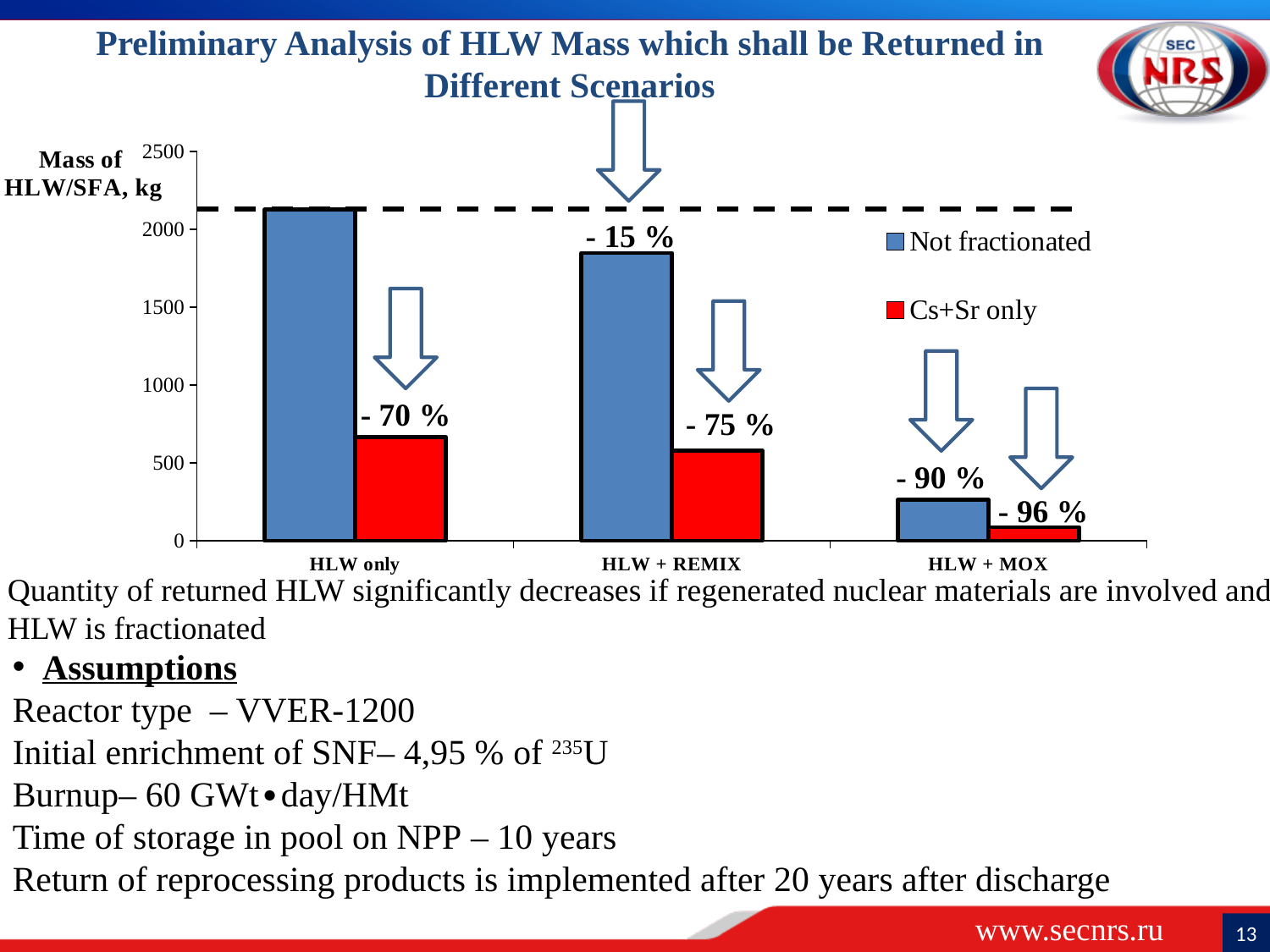
What percentage reduction is labelled above the Cs+Sr only bar for HLW + MOX? - 96 % Is the Not fractionated value for HLW + MOX greater or less than 500? less Is the Not fractionated value for HLW only greater or less than 2000? greater What is the label on the vertical axis of the chart? Mass of HLW/SFA, kg Which category has the lowest Cs+Sr only bar? HLW + MOX What kind of chart is shown on the slide? bar chart How many categories are shown on the x axis of the chart? 3 How many series does the chart legend list? 2 What percentage reduction is labelled above the Cs+Sr only bar for HLW only? - 70 % What percentage reduction is labelled above the Not fractionated bar for HLW + REMIX? - 15 % What are the two series named in the chart legend? Not fractionated; Cs+Sr only Which category has the highest Not fractionated bar? HLW only